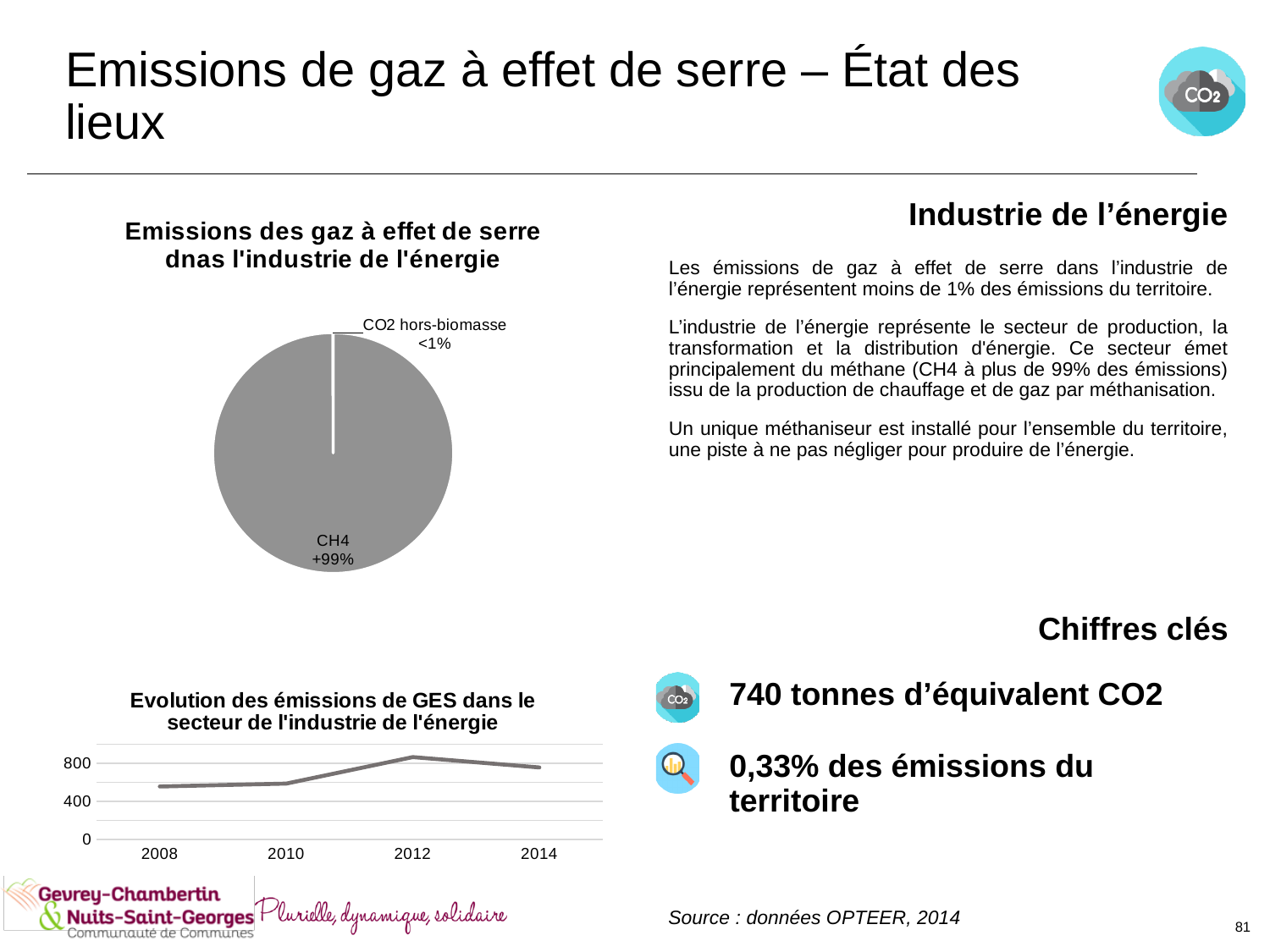
In the bottom-left line chart, do the values rise or fall between 2012 and 2014? fall How many slices does the pie chart on the left have? 2 In the pie chart on the left, what share of emissions is labelled for CH4? +99% In the bottom-left line chart, how many years are shown on the x axis? 4 In the bottom-left line chart, is the value for 2008 greater or less than 400? greater What kind of chart is the top-left chart titled "Emissions des gaz à effet de serre dnas l'industrie de l'énergie"? pie chart In the bottom-left line chart, is the value for 2014 greater or less than 800? less What kind of chart is the bottom-left chart titled "Evolution des émissions de GES dans le secteur de l'industrie de l'énergie"? line chart In the pie chart on the left, which slice is the largest? CH4 In the bottom-left line chart, which year has the highest value? 2012 In the bottom-left line chart, is the value for 2012 greater or less than 800? greater In the pie chart on the left, what share is labelled for CO2 hors-biomasse? <1%